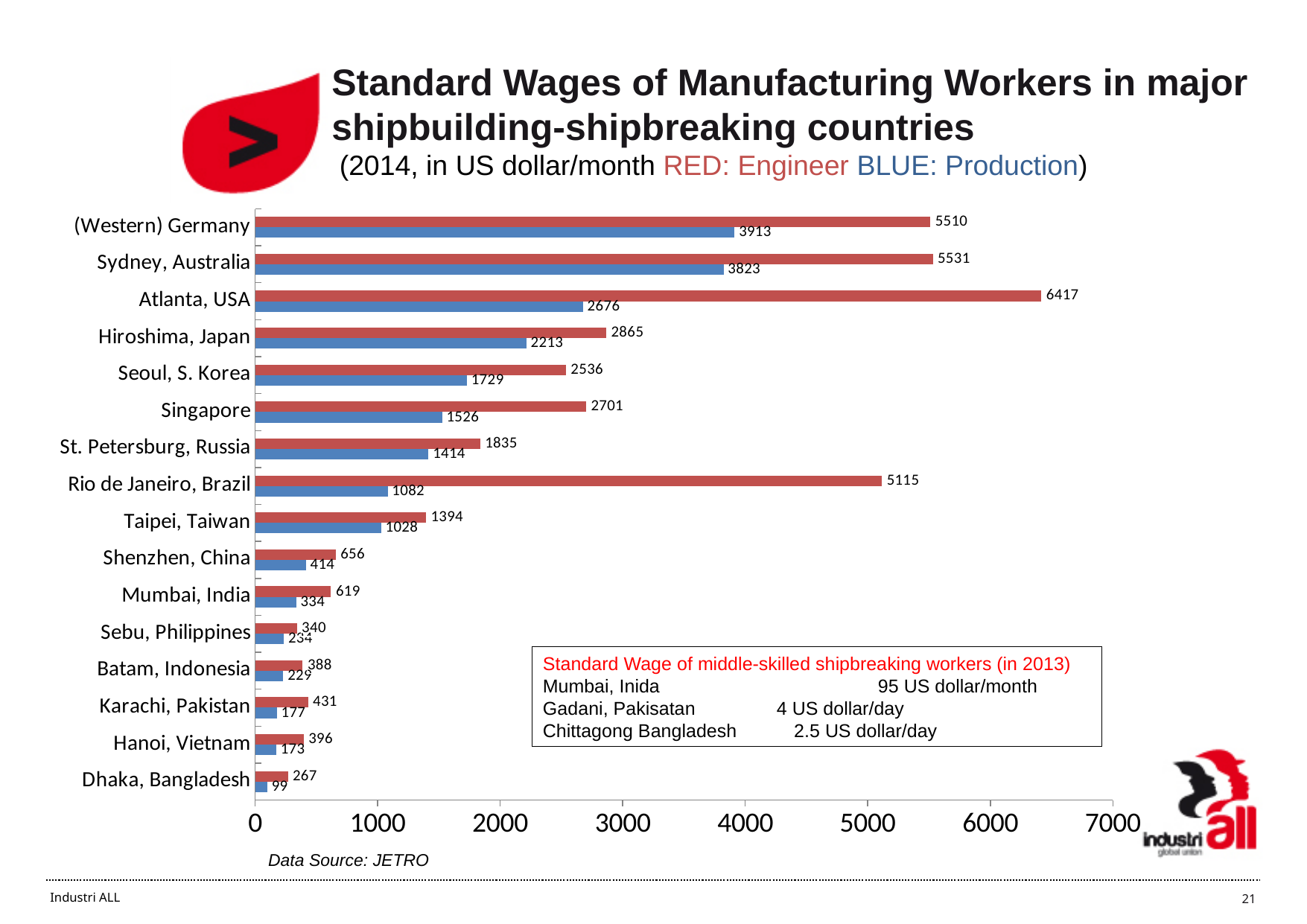
What is the Production wage for Dhaka, Bangladesh? 99 What kind of chart is shown on the slide? Bar chart Which city or country has the lowest Production wage? Dhaka, Bangladesh Which has the larger Engineer wage, Rio de Janeiro, Brazil or (Western) Germany? (Western) Germany Which city or country has the highest Engineer wage? Atlanta, USA What is the Production wage for Rio de Janeiro, Brazil? 1082 Is the Production wage for Hiroshima, Japan greater or less than 2000? greater What is the Engineer wage for Atlanta, USA? 6417 What is the difference between the Engineer and Production wages for (Western) Germany? 1597 How many cities or countries are shown on the chart? 16 How many data series does the chart show? 2 What is the difference between the Engineer and Production wages for Atlanta, USA? 3741